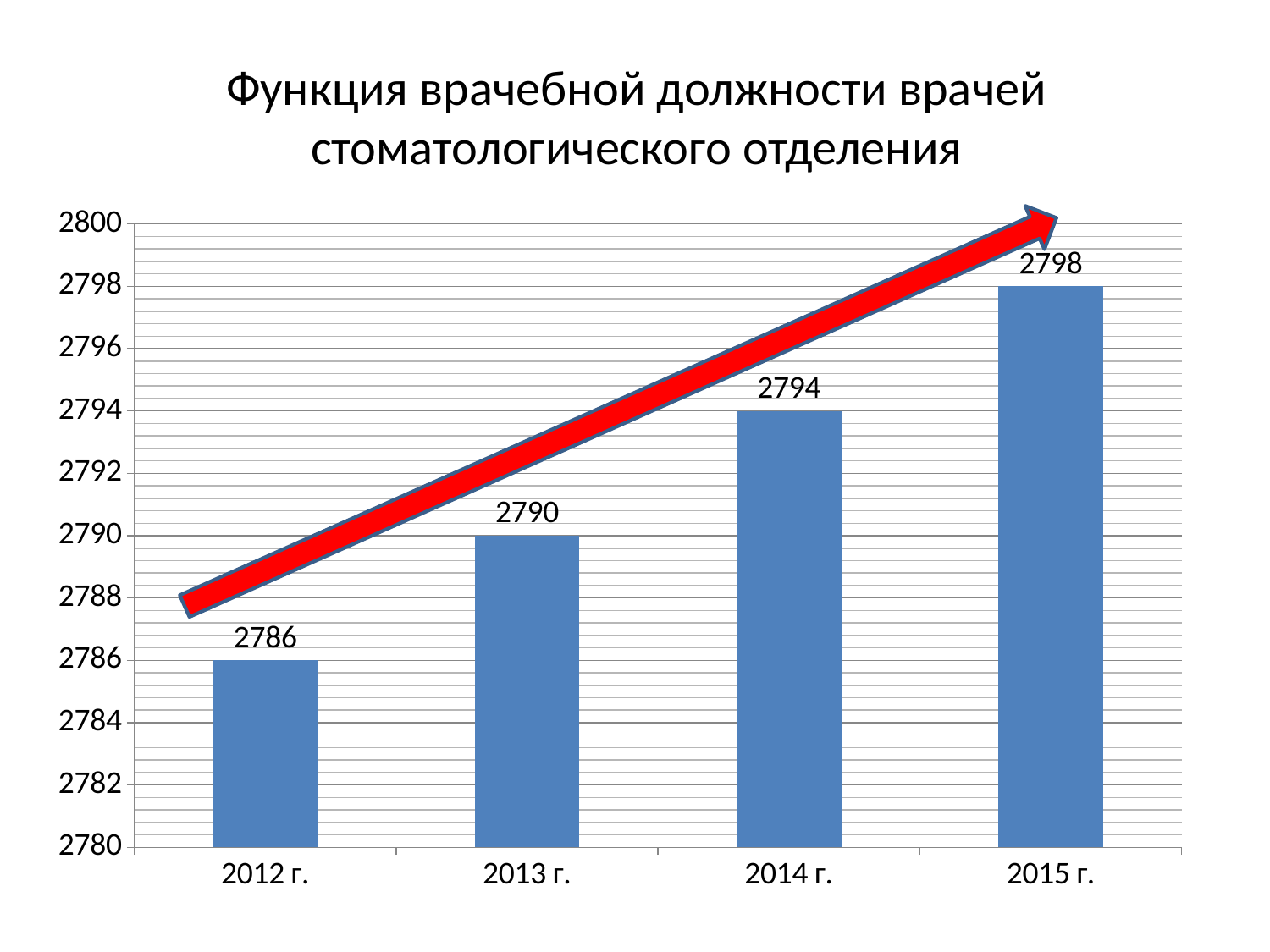
What kind of chart is this? bar chart What is the value for 2013 г.? 2790 What is the difference between the values for 2014 г. and 2013 г.? 4 What is the value for 2015 г.? 2798 Which is larger, the value for 2013 г. or the value for 2014 г.? 2014 г. What is the value for 2012 г.? 2786 How many years are shown on the chart? 4 Do the values rise or fall from 2012 г. to 2015 г.? rise What is the difference between the values for 2015 г. and 2012 г.? 12 What is the value for 2014 г.? 2794 Which year has the lowest value? 2012 г. Which year has the highest value? 2015 г.